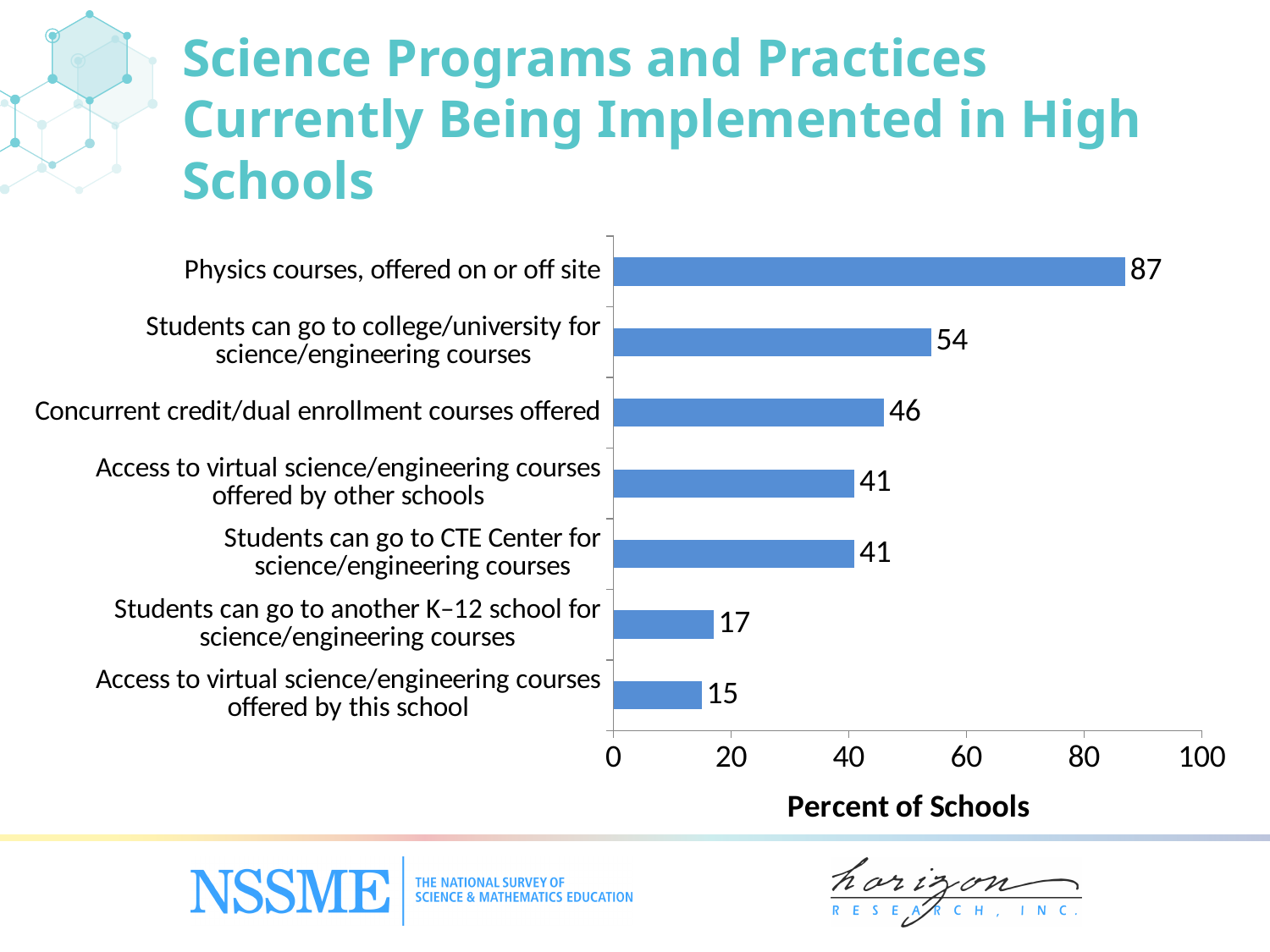
Which category has the lowest value? Access to virtual science/engineering courses offered by this school What is the value for 'Concurrent credit/dual enrollment courses offered'? 46 Which category has the highest value? Physics courses, offered on or off site What is the difference between the value for 'Physics courses, offered on or off site' and the value for 'Students can go to college/university for science/engineering courses'? 33 Which is larger: the value for 'Concurrent credit/dual enrollment courses offered' or the value for 'Students can go to CTE Center for science/engineering courses'? Concurrent credit/dual enrollment courses offered How many categories are shown in the chart? 7 What percent of schools report that students can go to another K–12 school for science/engineering courses? 17 What kind of chart is shown on the slide? Bar chart Is the value for 'Students can go to college/university for science/engineering courses' greater or less than 60? less What percent of schools offer physics courses on or off site? 87 What is the difference between the value for 'Students can go to another K–12 school for science/engineering courses' and the value for 'Access to virtual science/engineering courses offered by this school'? 2 What is the label of the horizontal axis? Percent of Schools